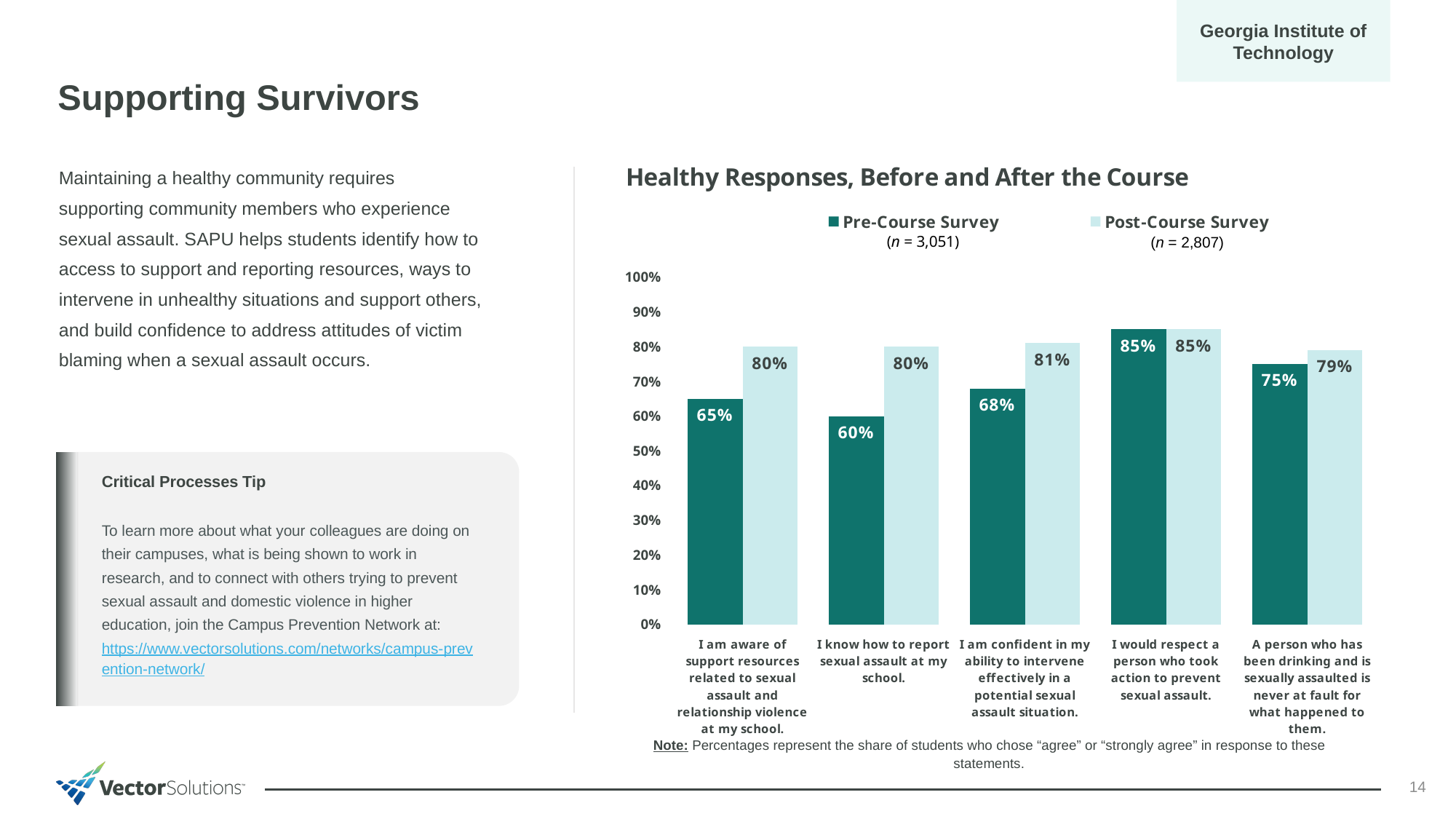
What is the Post-Course Survey value for "I know how to report sexual assault at my school"? 80% What type of chart is shown on the slide? Bar chart What is the difference between the Post-Course and Pre-Course Survey values for "I know how to report sexual assault at my school"? 20% How many statements (categories) are shown on the x axis of the chart? 5 Which statement has the lowest Pre-Course Survey value? I know how to report sexual assault at my school. What is the Pre-Course Survey value for "I am aware of support resources related to sexual assault and relationship violence at my school"? 65% What is the difference between the Post-Course and Pre-Course Survey values for "A person who has been drinking and is sexually assaulted is never at fault for what happened to them"? 4% What is the title of the chart? Healthy Responses, Before and After the Course Which is larger for "I am confident in my ability to intervene effectively in a potential sexual assault situation": the Pre-Course Survey value or the Post-Course Survey value? Post-Course Survey What is the Post-Course Survey value for "I am confident in my ability to intervene effectively in a potential sexual assault situation"? 81% Which statement has the highest Post-Course Survey value? I would respect a person who took action to prevent sexual assault. How many series does the chart legend list? 2